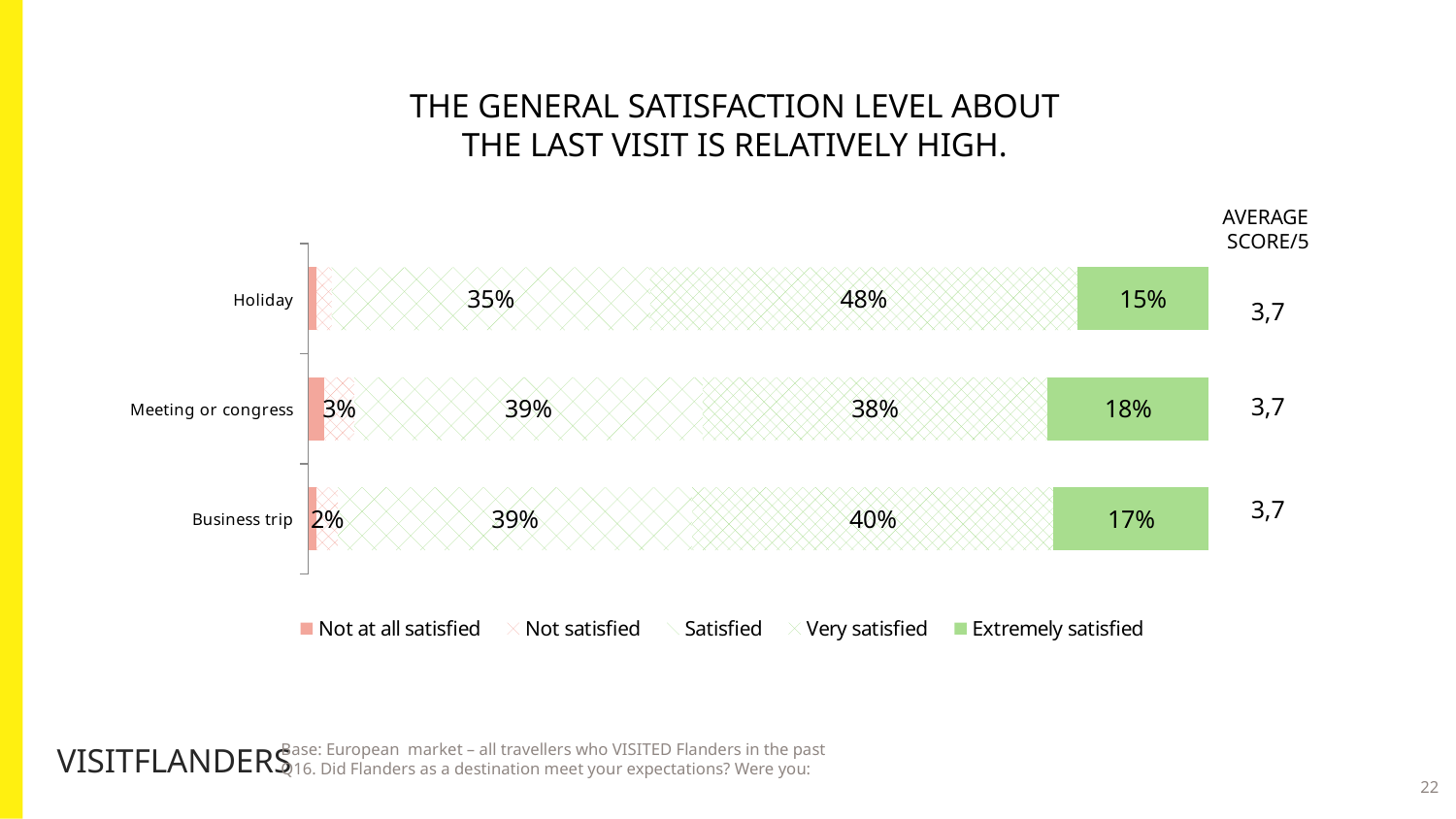
Which category has the lowest share of Very satisfied travellers? Meeting or congress What percentage of Holiday travellers were Very satisfied? 48% For Holiday, how many percentage points higher is the Very satisfied share than the Extremely satisfied share? 33 percentage points Which category has the highest share of Extremely satisfied travellers? Meeting or congress What percentage of Meeting or congress travellers were Extremely satisfied? 18% What is the average score out of 5 shown for Holiday? 3,7 What percentage of Business trip travellers were Satisfied? 39% How many series does the legend list? 5 For Business trip, which is larger: the Satisfied share or the Very satisfied share? Very satisfied What percentage of Holiday travellers were Satisfied? 35% How many trip categories are shown in the chart? 3 What kind of chart is shown on the slide? Stacked horizontal bar chart